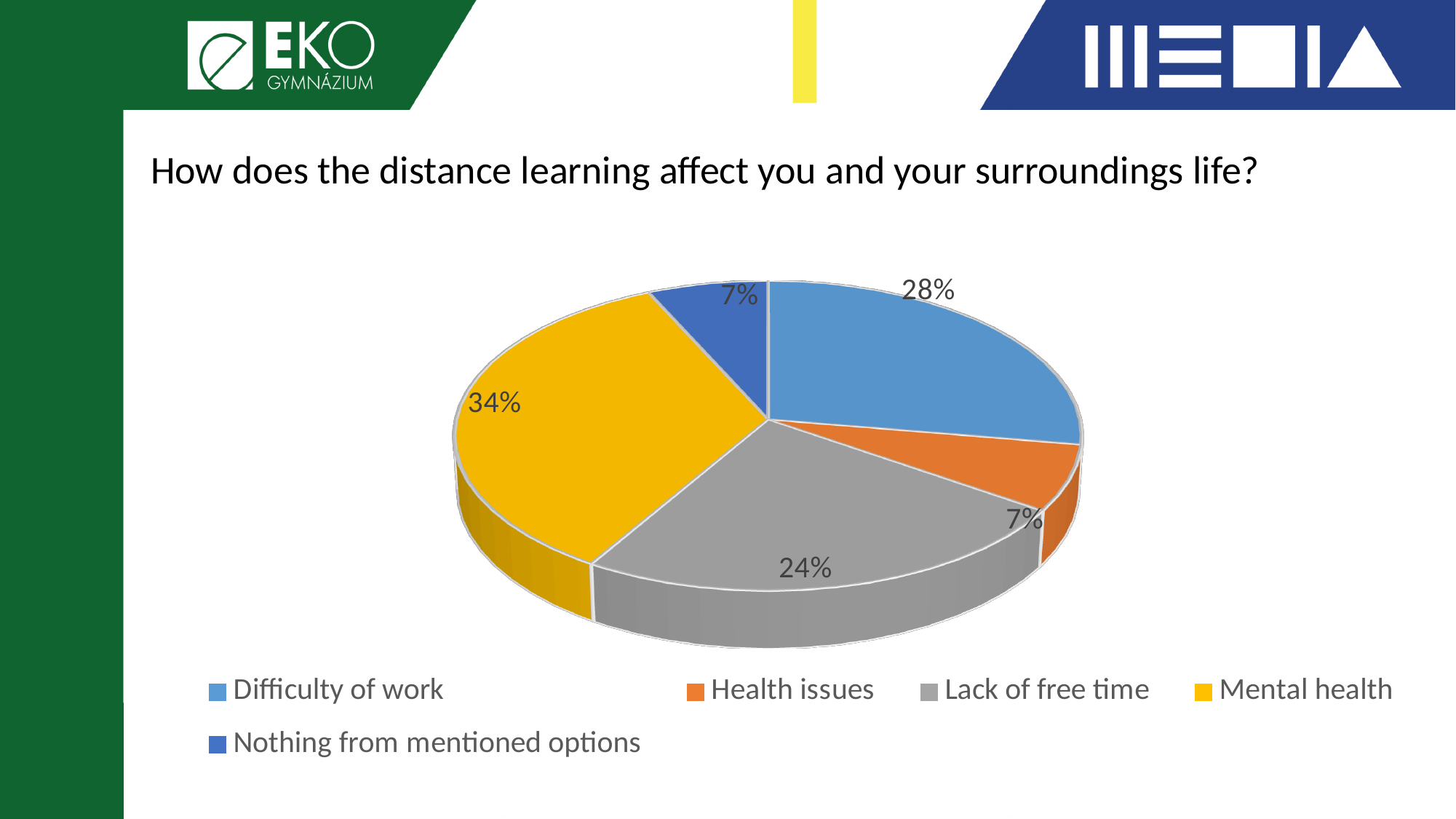
What kind of chart is shown on the slide? Pie chart What is the title of the chart? How does the distance learning affect you and your surroundings life? Which category has the largest slice of the pie? Mental health What is the difference between the Mental health share and the Difficulty of work share? 6% What share of the pie does Difficulty of work have? 28% What is the smallest percentage shown on the pie chart? 7% What share of the pie does Nothing from mentioned options have? 7% Which is larger, the share for Difficulty of work or the share for Lack of free time? Difficulty of work What share of the pie does Lack of free time have? 24% How many categories does the pie chart show? 5 What share of the pie does Mental health have? 34% What share of the pie does Health issues have? 7%